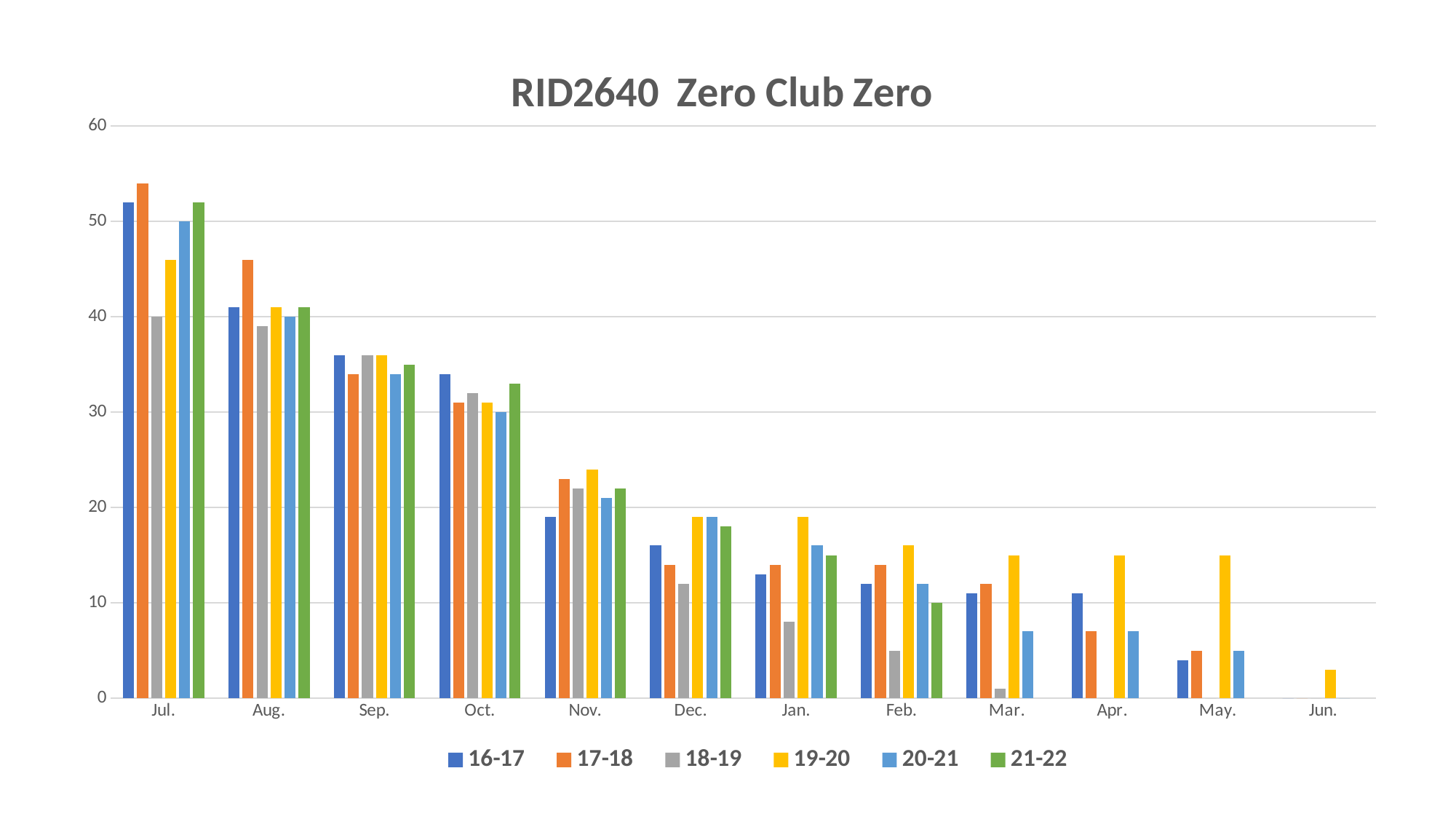
How many series does the legend list? 6 What kind of chart is shown on the slide? bar chart Is the value for 21-22 in Oct. greater or less than 30? greater Is the value for 17-18 in Jul. greater or less than 50? greater Which series has the highest value in Aug.? 17-18 Is the value for 19-20 in Apr. greater or less than 10? greater What is the title of the chart? RID2640 Zero Club Zero Do the values for the 16-17 series rise or fall from Jul. to May.? fall Which series has the lowest value in Nov.? 16-17 In Apr., which is larger, the value for 16-17 or the value for 17-18? 16-17 How many month categories are shown on the x axis? 12